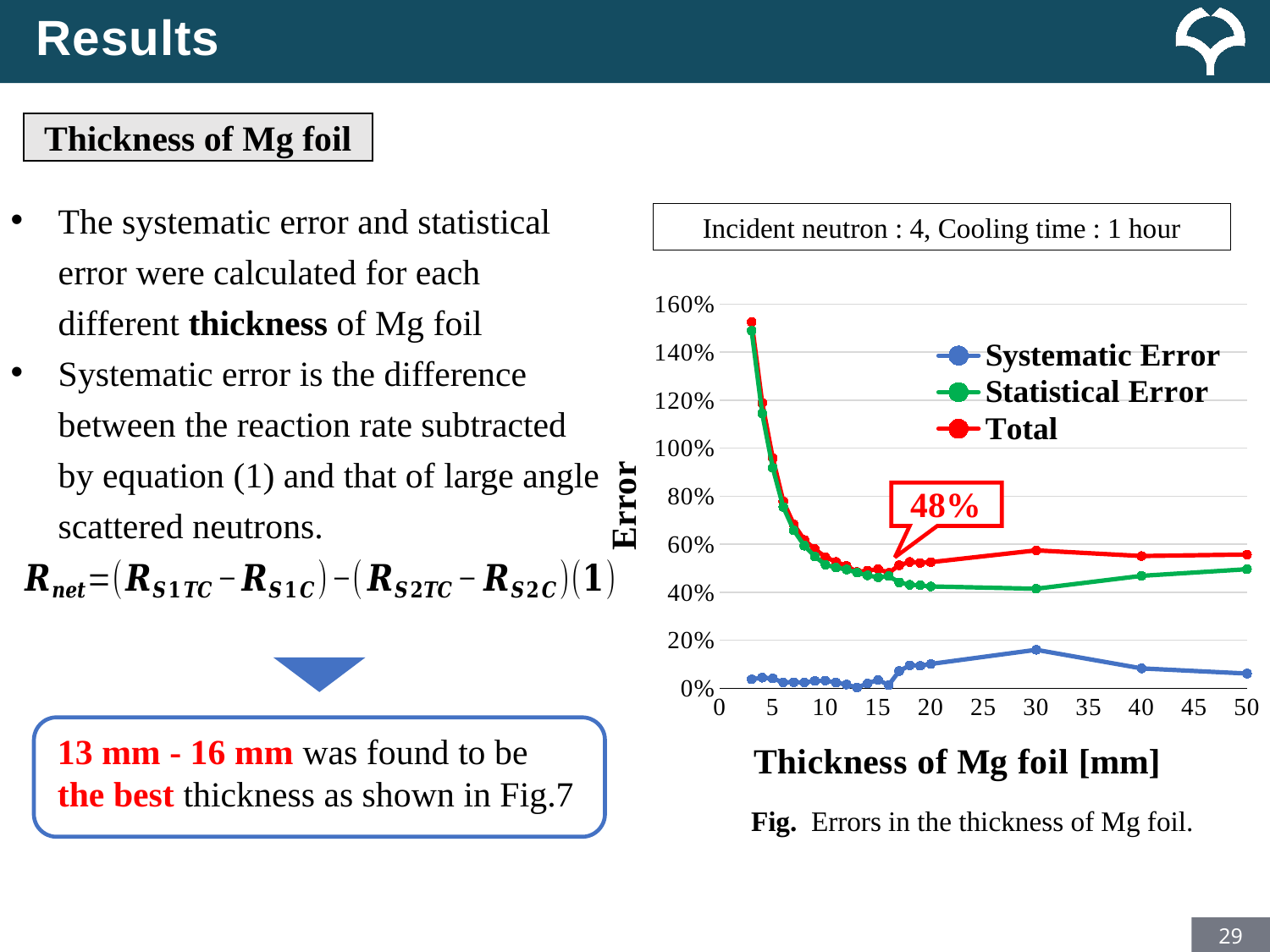
Does the Total error rise or fall as thickness increases from 3 mm to 15 mm? fall What kind of chart is shown on the slide? line chart Which series has the lowest values across the whole thickness range? Systematic Error Is the Total error at the smallest thickness (about 3 mm) greater or less than 140%? greater At 30 mm, which is larger: the Total error or the Systematic Error? Total Is the Statistical Error at 30 mm greater or less than 60%? less Is the Systematic Error at 30 mm greater or less than 20%? less What value does the callout label on the Total line show? 48% What is the title of the x axis of the chart? Thickness of Mg foil [mm] How many series does the chart legend list? 3 Does the Systematic Error rise or fall as thickness increases from 15 mm to 30 mm? rise